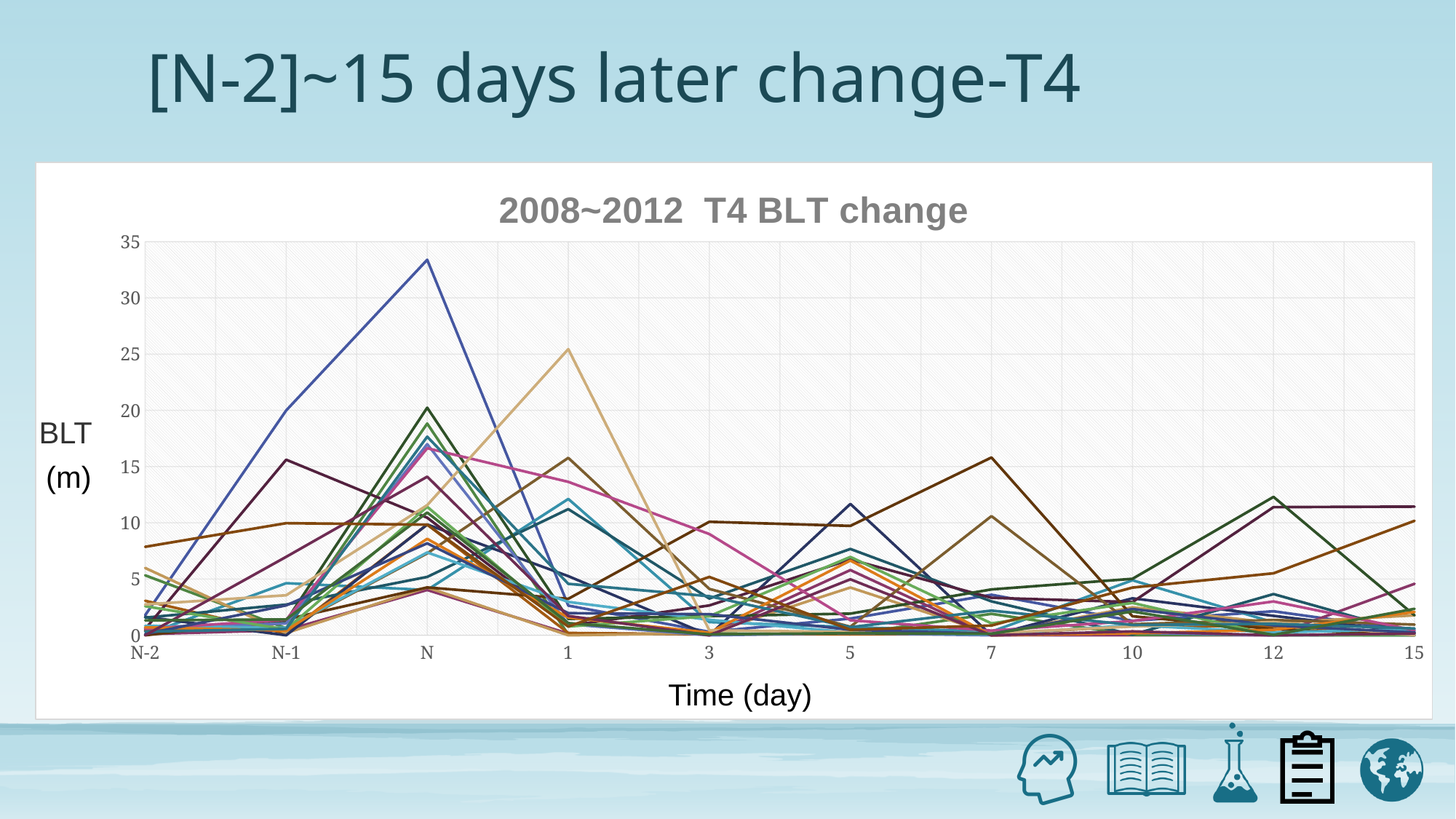
Is the highest value plotted at day 7 greater or less than 20? less How many tick labels are shown along the x axis? 10 Is the highest value plotted at day 15 greater or less than 15? less At which x-axis point does the highest value on the whole chart occur? N What kind of chart is shown on the slide? line chart What is the label of the x axis? Time (day) Which has the larger peak value: the lines at N or the lines at day 1? N What is the highest tick value shown on the y axis? 35 Is the highest value plotted at N greater or less than 30? greater What is the title of the chart? 2008~2012 T4 BLT change